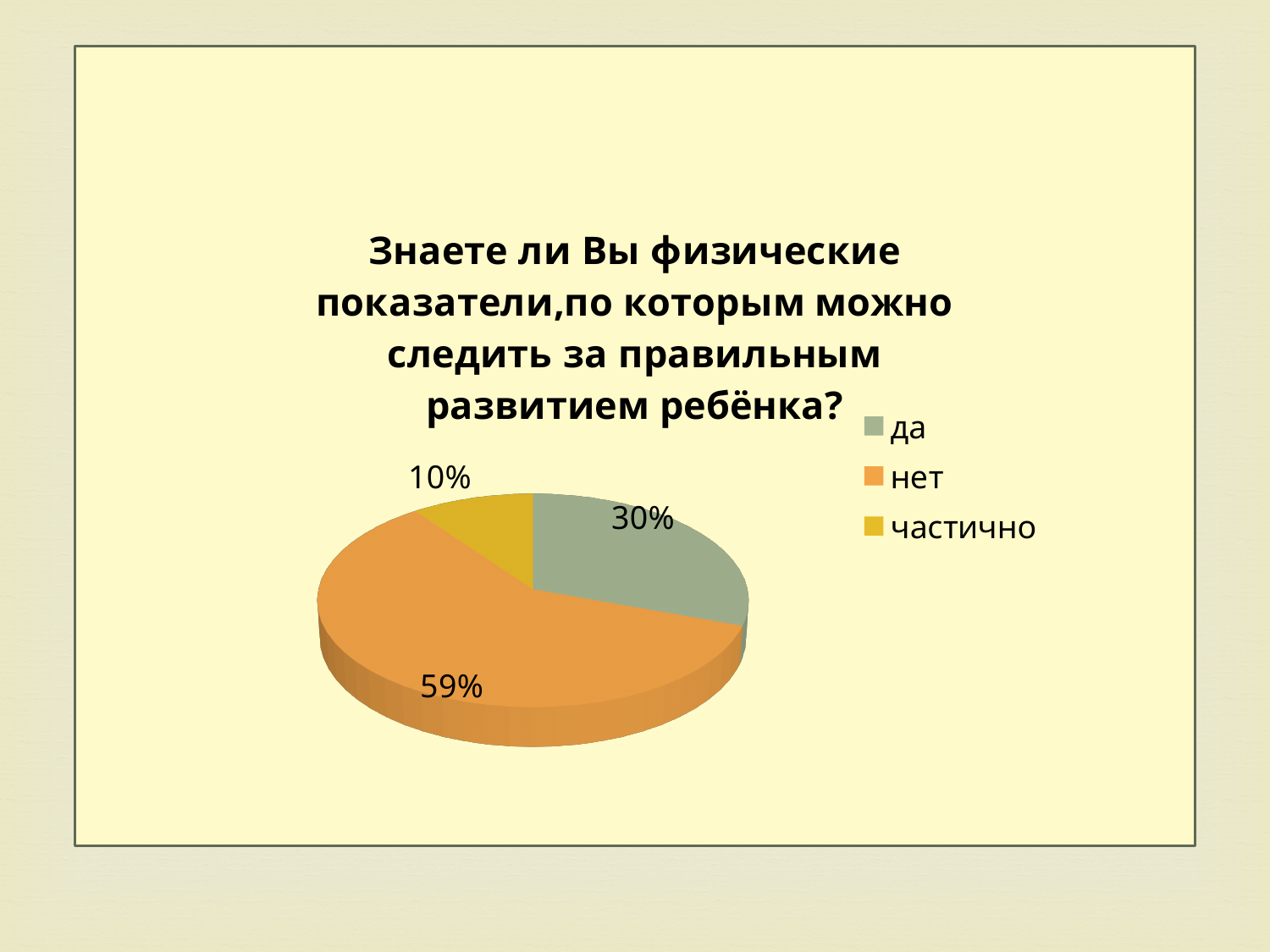
How many categories does the pie chart show? 3 What is the difference in percentage points between "нет" and "да"? 29 What is the difference in percentage points between "да" and "частично"? 20 Which is larger, the share for "да" or the share for "частично"? да What share of the pie does "да" take? 30% What colour is the slice for "нет"? orange What share of the pie does "частично" take? 10% Which category has the largest slice? нет Which category has the smallest slice? частично Which legend entry is listed first? да What share of the pie does "нет" take? 59% What kind of chart is shown on the slide? pie chart